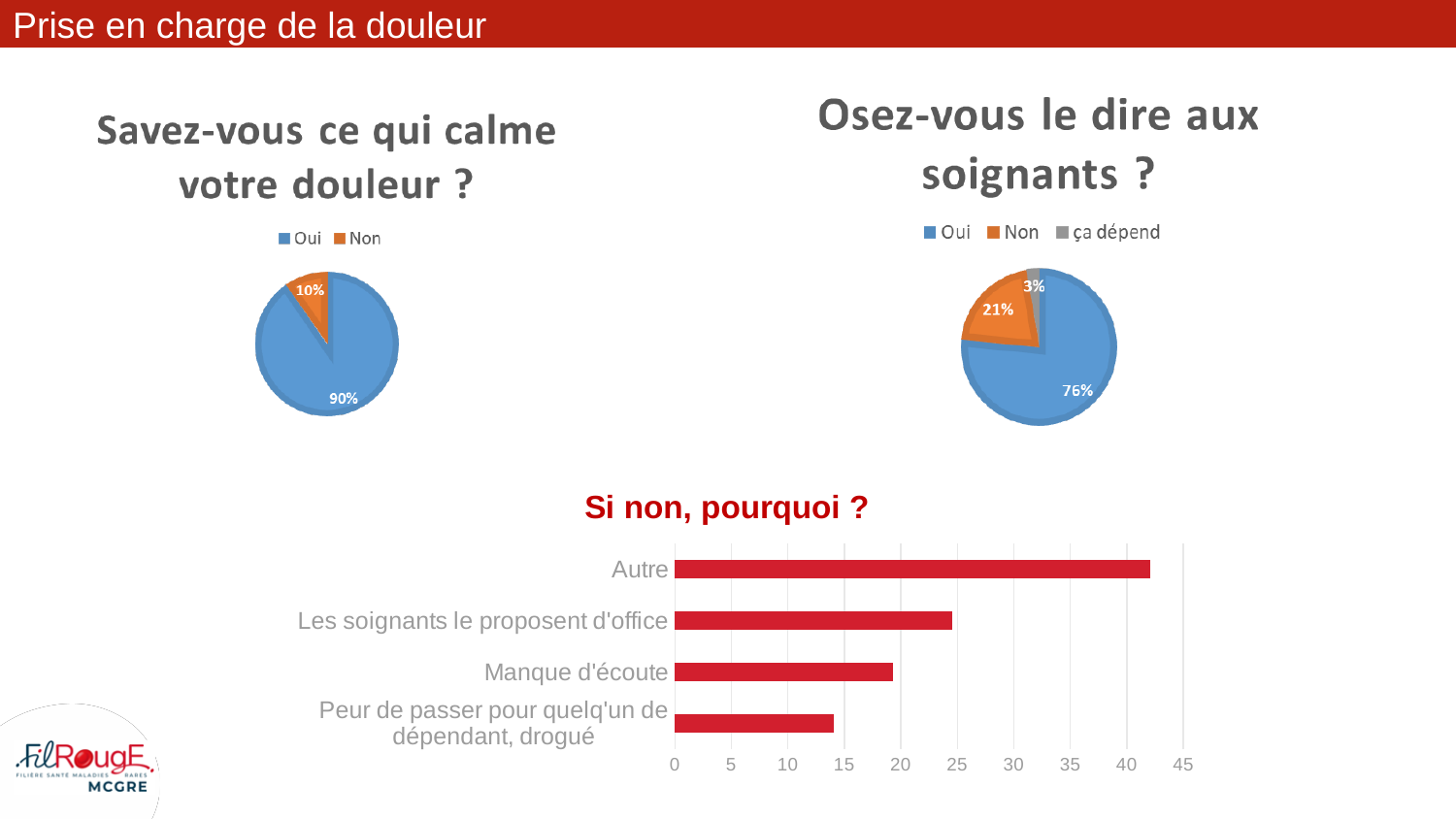
How many entries does the legend of the pie chart 'Osez-vous le dire aux soignants ?' list? 3 In the bar chart 'Si non, pourquoi ?', which category has the highest value? Autre In the bar chart 'Si non, pourquoi ?', is the value for 'Manque d'écoute' greater or less than 15? greater In the pie chart 'Osez-vous le dire aux soignants ?', what share is 'Non'? 21% In the pie chart 'Savez-vous ce qui calme votre douleur ?', what share is 'Oui'? 90% In the pie chart 'Osez-vous le dire aux soignants ?', what is the difference in percentage points between 'Oui' and 'Non'? 55 In the pie chart 'Osez-vous le dire aux soignants ?', which category has the largest share? Oui What kind of chart is 'Si non, pourquoi ?'? Bar chart In the pie chart 'Osez-vous le dire aux soignants ?', which category has the smallest share? ça dépend In the bar chart 'Si non, pourquoi ?', how many categories are shown? 4 In the pie chart 'Osez-vous le dire aux soignants ?', what share is 'ça dépend'? 3% In the pie chart 'Savez-vous ce qui calme votre douleur ?', what share is 'Non'? 10%